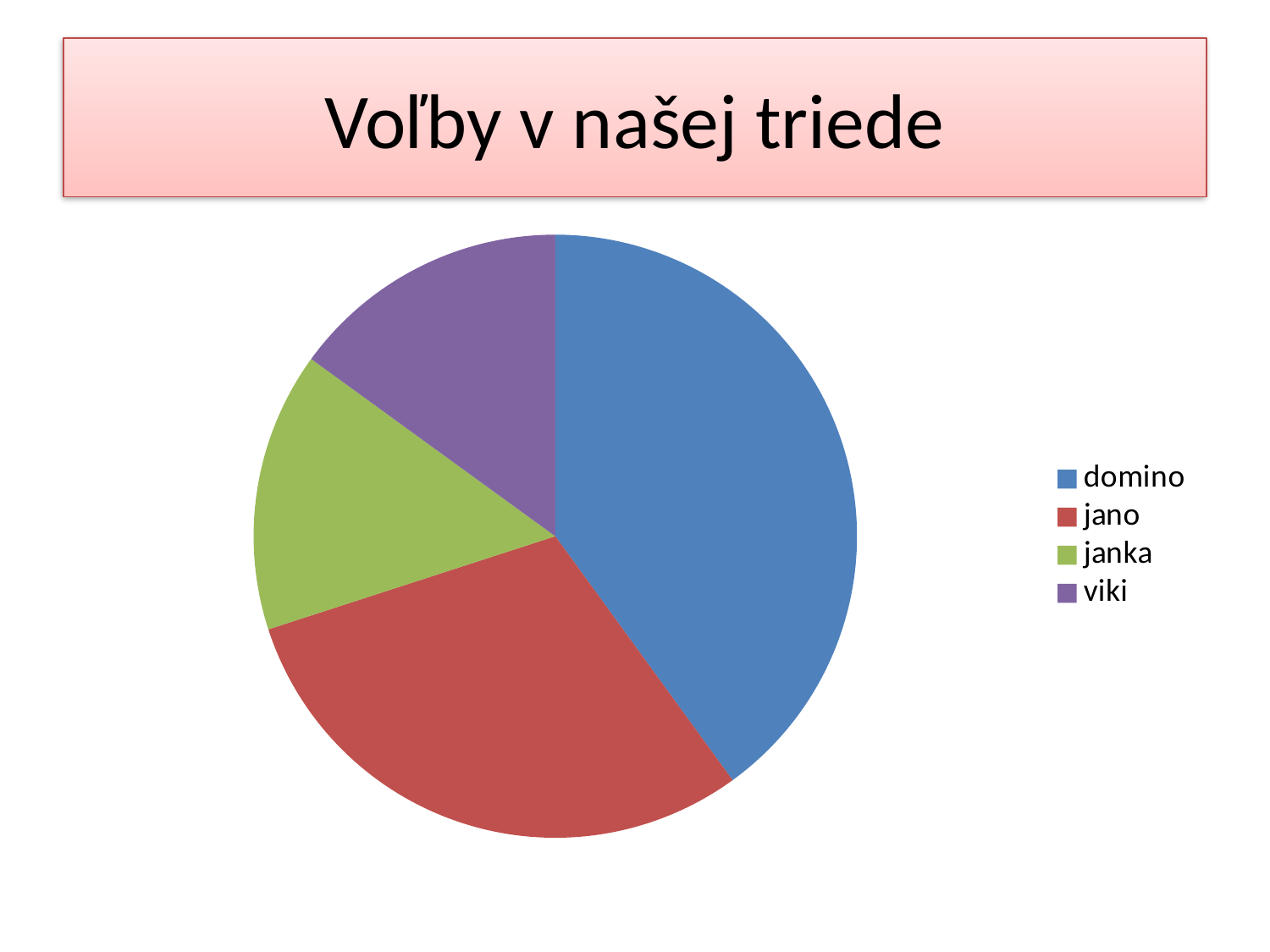
What kind of chart is shown on the slide? pie chart Which slice is larger, domino or jano? domino Which slice is larger, domino or janka? domino Which slice is larger, domino or viki? domino What is the title of the slide containing the pie chart? Voľby v našej triede How many slices does the pie chart have? 4 How many entries does the legend list? 4 Which category has the largest slice of the pie? domino What colour is the slice for jano? red